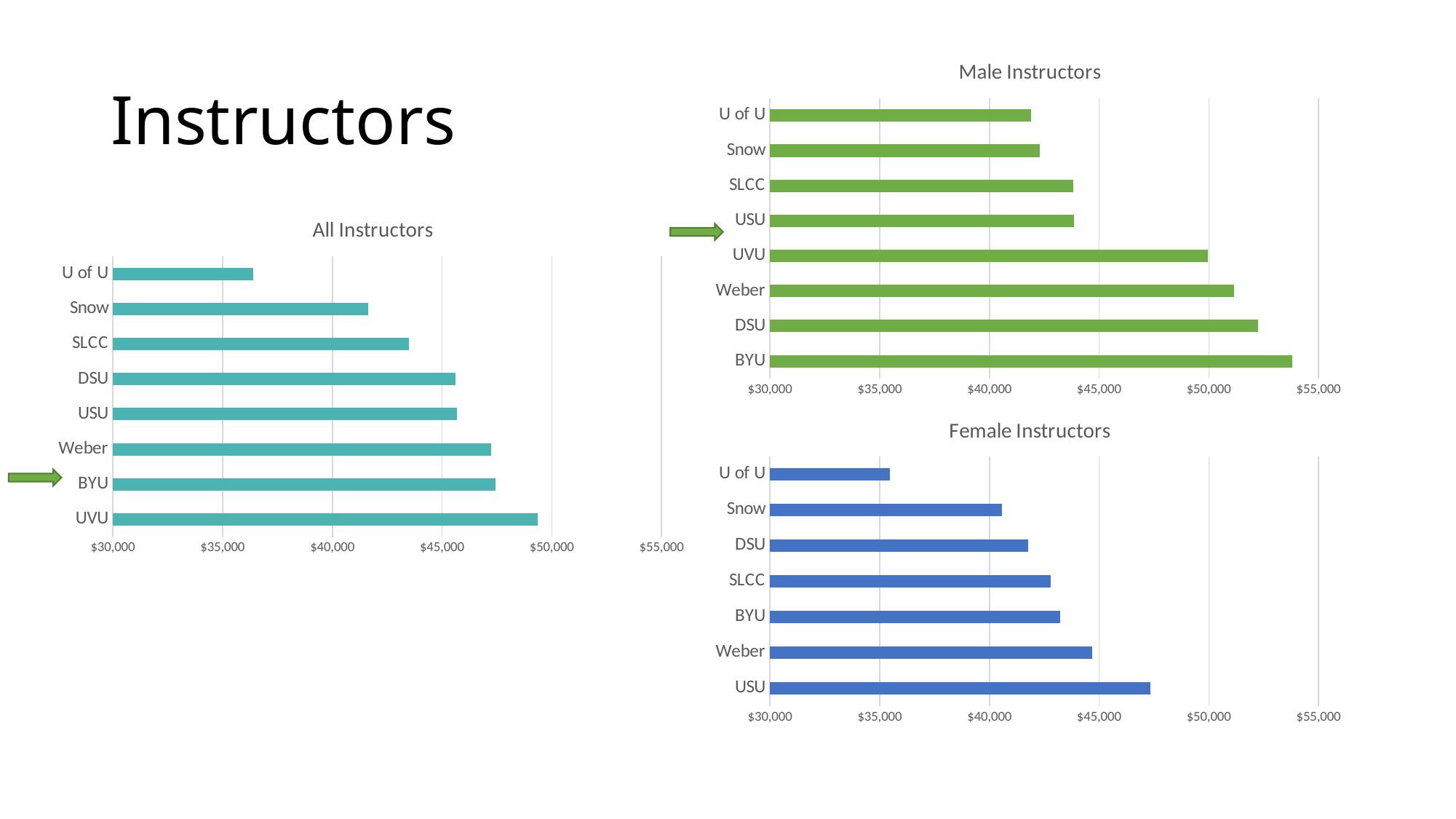
In the Male Instructors chart, which institution has the highest value? BYU In the All Instructors chart, is the value for U of U greater or less than $40,000? less In the All Instructors chart, is the value for UVU greater or less than $45,000? greater In the Female Instructors chart, is the value for U of U greater or less than $40,000? less How many institutions are shown in the Female Instructors chart? 7 In the All Instructors chart, which institution has the lowest value? U of U What kind of chart is the Male Instructors chart? bar chart In the Female Instructors chart, which institution has the highest value? USU In the Female Instructors chart, which is larger, the value for Weber or the value for Snow? Weber In the All Instructors chart, which institution has the highest value? UVU In the Female Instructors chart, which institution has the lowest value? U of U